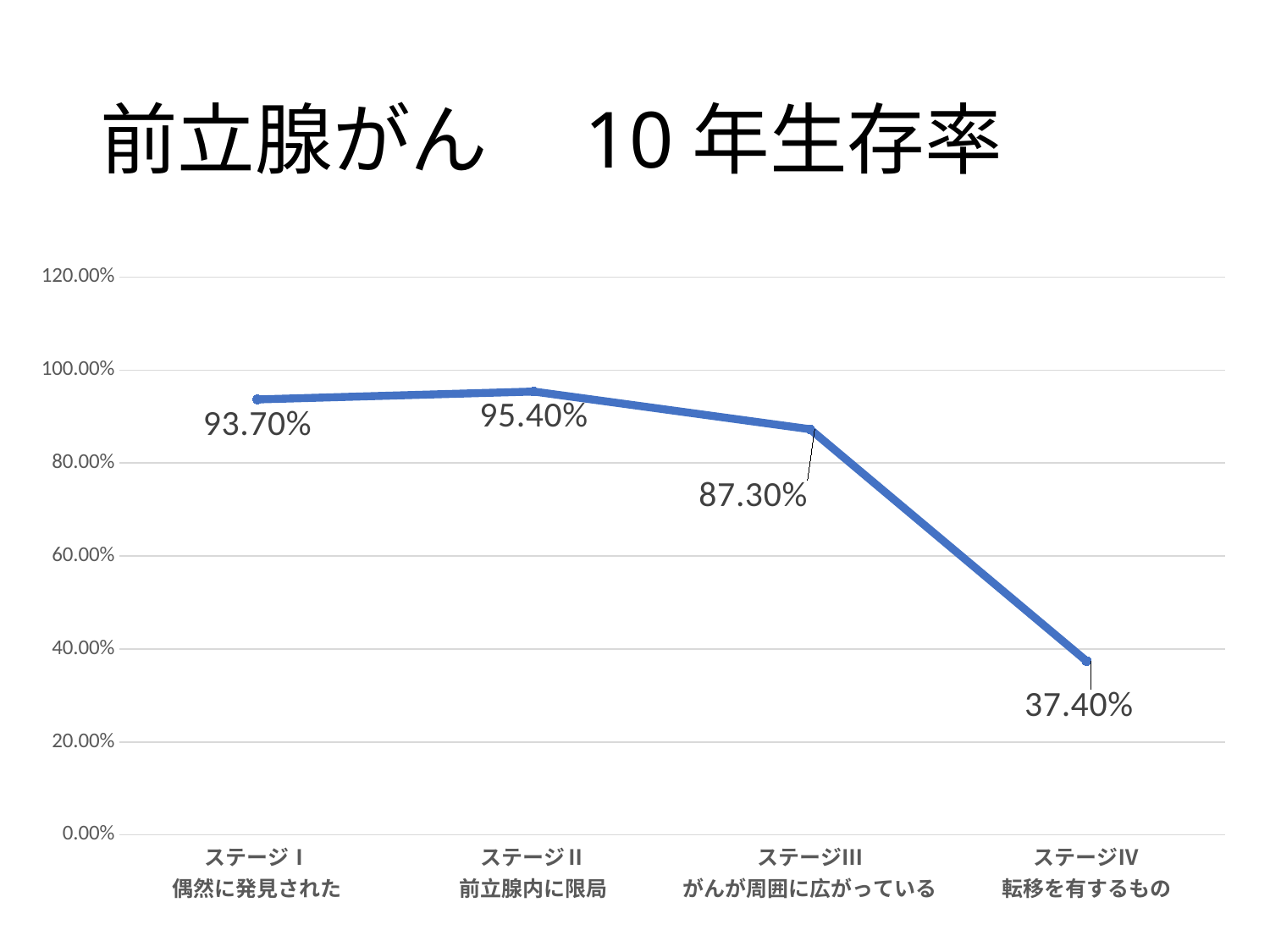
What is the difference between the survival rates for ステージⅡ and ステージⅠ? 1.70% Is the value for ステージⅣ greater or less than 40.00%? less What is the difference between the survival rates for ステージⅢ and ステージⅣ? 49.90% What is the 10-year survival rate for ステージⅠ (偶然に発見された)? 93.70% How many stages are plotted on the chart? 4 What is the 10-year survival rate for ステージⅡ (前立腺内に限局)? 95.40% Which has a higher 10-year survival rate, ステージⅠ or ステージⅢ? ステージⅠ What is the 10-year survival rate for ステージⅢ (がんが周囲に広がっている)? 87.30% Which stage has the highest 10-year survival rate? ステージⅡ What is the 10-year survival rate for ステージⅣ (転移を有するもの)? 37.40% What kind of chart is shown on the slide? line chart Which stage has the lowest 10-year survival rate? ステージⅣ